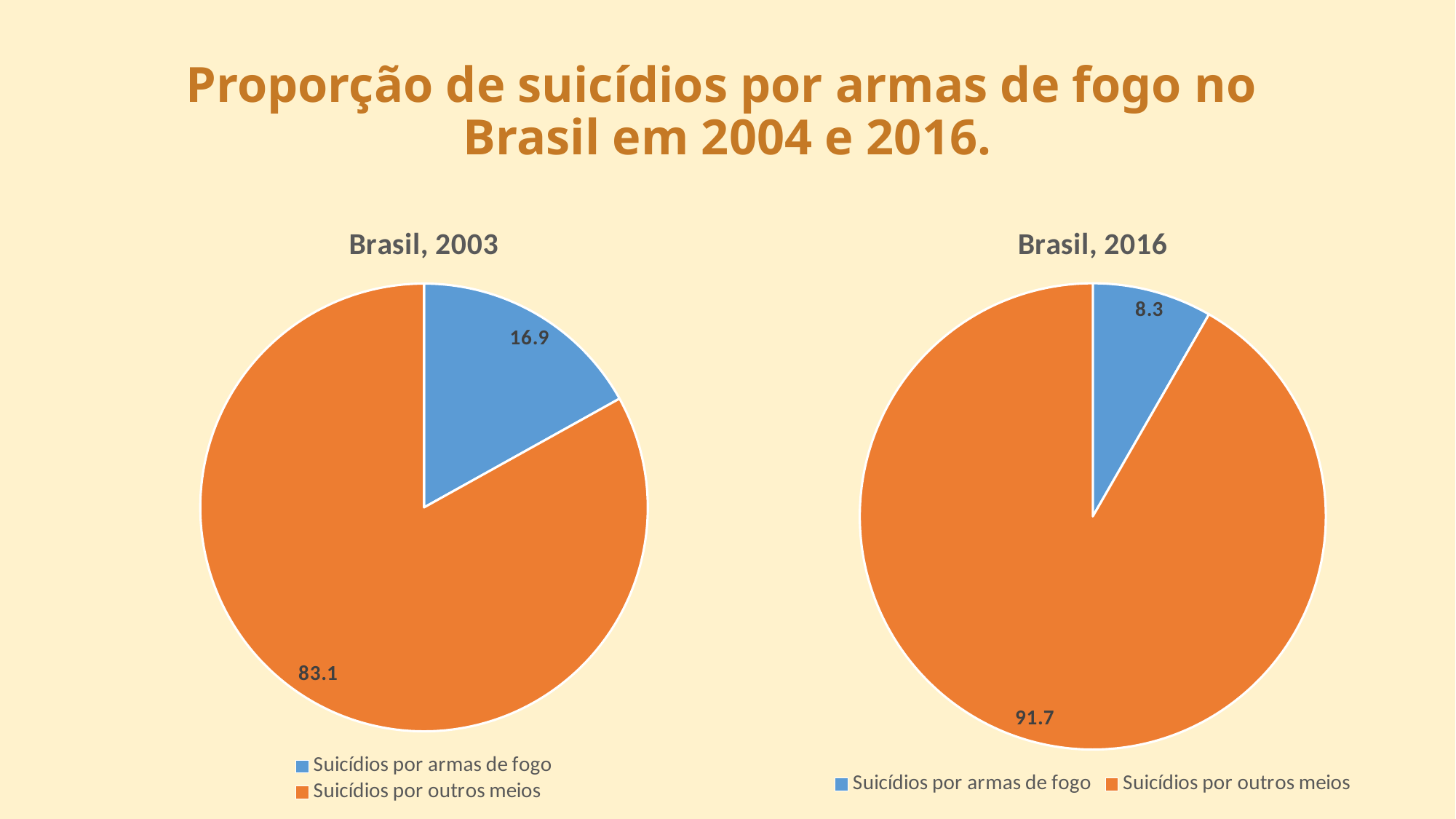
In the 'Brasil, 2016' chart, which category has the smallest slice? Suicídios por armas de fogo In the 'Brasil, 2003' chart, what is the difference between 'Suicídios por outros meios' and 'Suicídios por armas de fogo'? 66.2 In the 'Brasil, 2003' chart, what is the value for 'Suicídios por armas de fogo'? 16.9 Which is larger: the 'Suicídios por armas de fogo' value in the 'Brasil, 2003' chart or in the 'Brasil, 2016' chart? Brasil, 2003 In the 'Brasil, 2016' chart, what is the value for 'Suicídios por outros meios'? 91.7 In the 'Brasil, 2016' chart, what colour is the 'Suicídios por outros meios' slice? Orange In the 'Brasil, 2003' chart, which category has the largest slice? Suicídios por outros meios How many slices does the 'Brasil, 2003' pie chart have? 2 In the 'Brasil, 2003' chart, what is the value for 'Suicídios por outros meios'? 83.1 How many entries does the legend of the 'Brasil, 2016' chart list? 2 What kind of chart is the 'Brasil, 2016' chart? Pie chart In the 'Brasil, 2016' chart, what is the value for 'Suicídios por armas de fogo'? 8.3